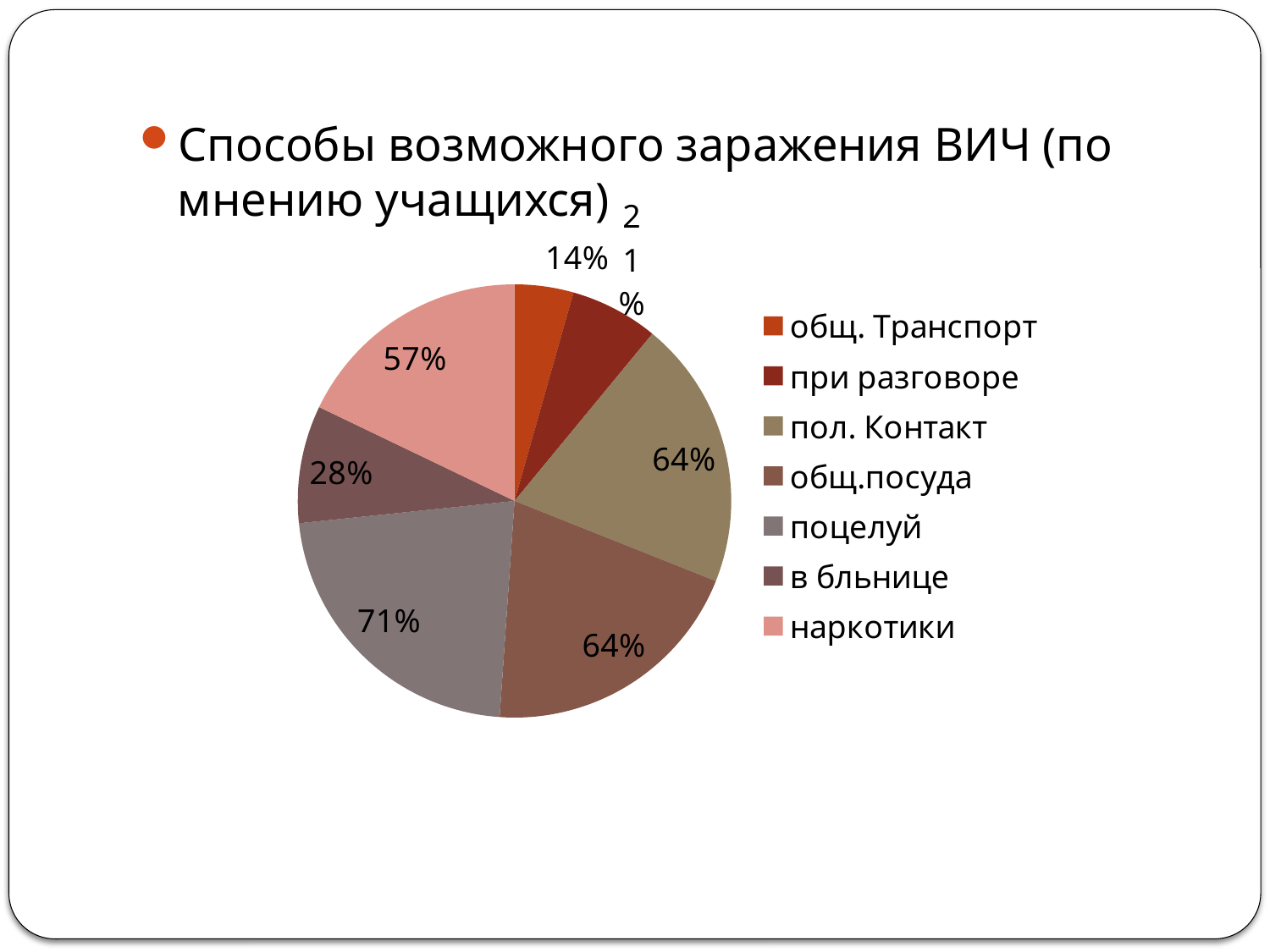
What is the value shown for пол. Контакт? 64% What colour is the slice for общ. Транспорт? orange-red Which category has the lowest value? общ. Транспорт How many categories does the legend list? 7 What is the value shown for поцелуй? 71% Which category has the highest value? поцелуй What is the difference between the values for поцелуй and наркотики? 14% What is the value shown for в бльнице? 28% Which has a larger value, наркотики or в бльнице? наркотики What is the value shown for наркотики? 57% What is the value shown for общ. Транспорт? 14% What type of chart is shown on the slide? pie chart